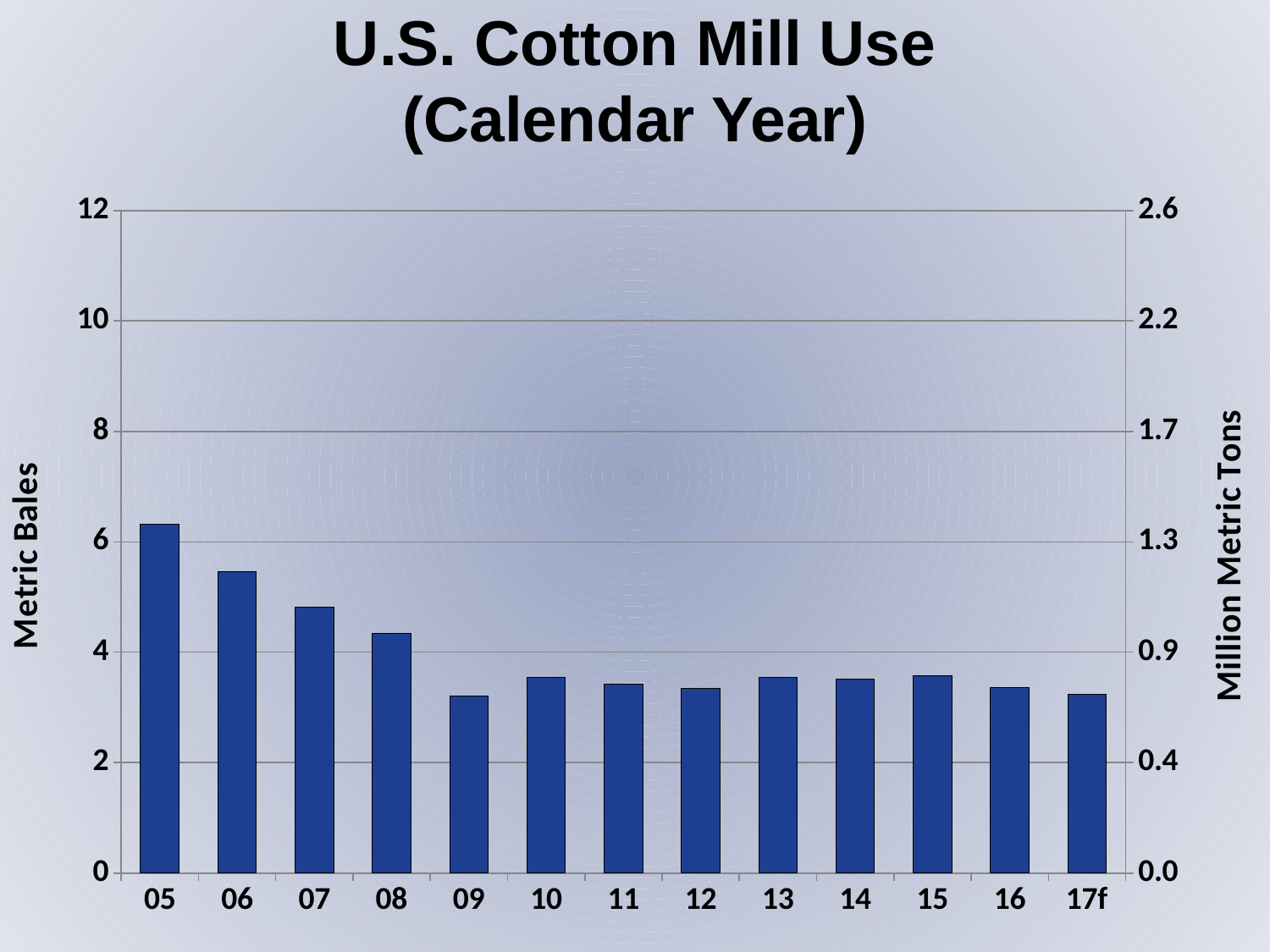
What is the label on the right-hand vertical axis? Million Metric Tons Is the value for 06 greater or less than 6 metric bales? less Which is larger, the value for 07 or the value for 08? 07 What kind of chart is shown on the slide? Bar chart Is the value for 17f greater or less than 4 metric bales? less Is the value for 08 greater or less than 4 metric bales? greater Which year has the highest U.S. cotton mill use? 05 Which is larger, the value for 06 or the value for 10? 06 How many years (bars) are plotted on the chart? 13 Do the values generally rise or fall from 05 to 09? Fall